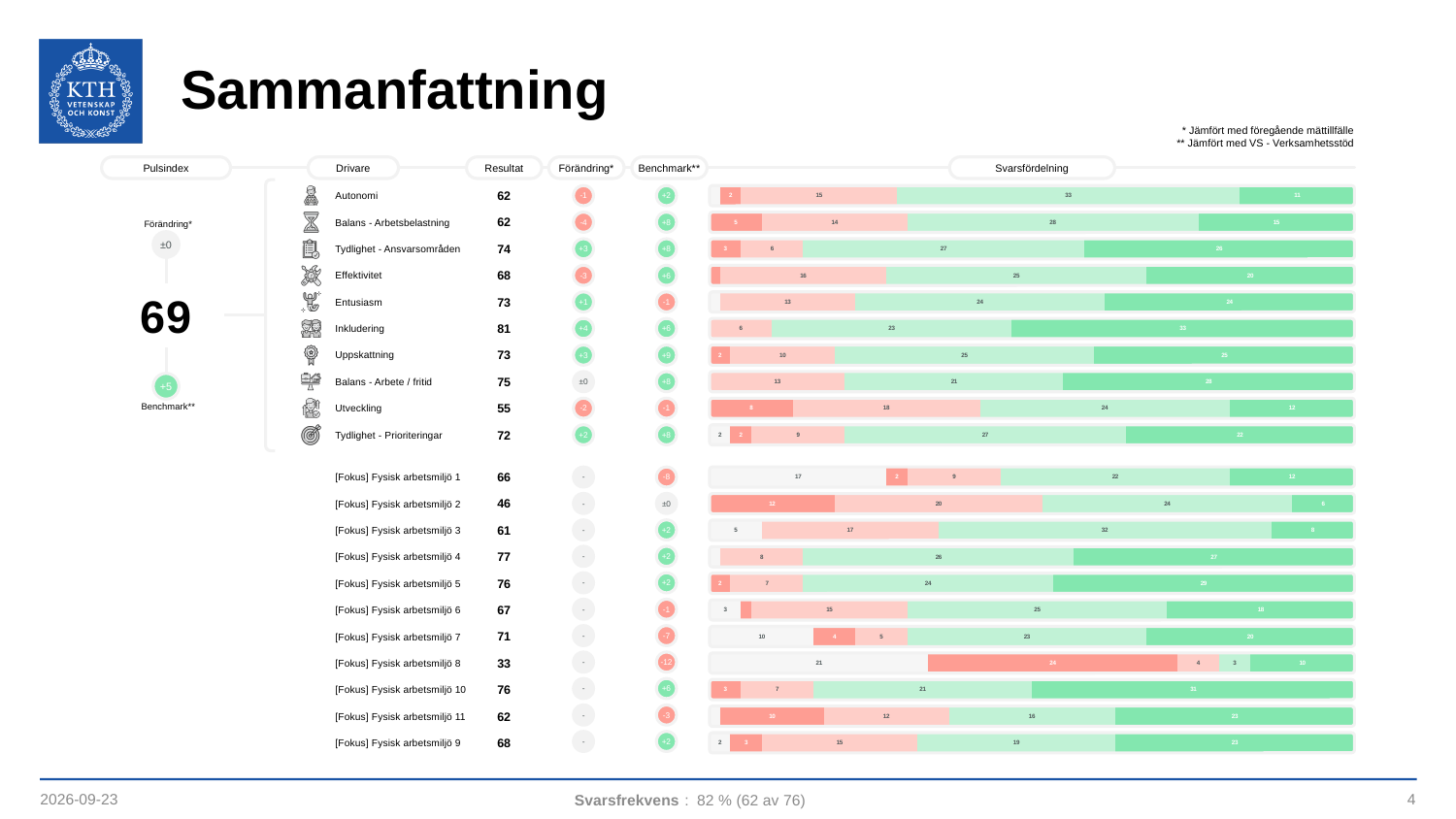
In the Svarsfördelning bar for Autonomi, how many responses are in the largest (light green) segment? 33 What kind of chart is used in the Svarsfördelning column? Stacked bar chart What is the overall Pulsindex value shown on the slide? 69 Which row has the lowest Resultat value on the slide? [Fokus] Fysisk arbetsmiljö 8 Which Drivare has the highest Resultat value? Inkludering How many [Fokus] Fysisk arbetsmiljö rows are listed on the slide? 11 What is the Resultat value for Utveckling? 55 What is the Resultat value for Inkludering? 81 What is the Benchmark** value for [Fokus] Fysisk arbetsmiljö 8? -12 What is the difference between the Resultat values for Inkludering and Utveckling? 26 What is the Förändring* value for Balans - Arbetsbelastning? -4 Which has a higher Resultat value, Effektivitet or Balans - Arbete / fritid? Balans - Arbete / fritid